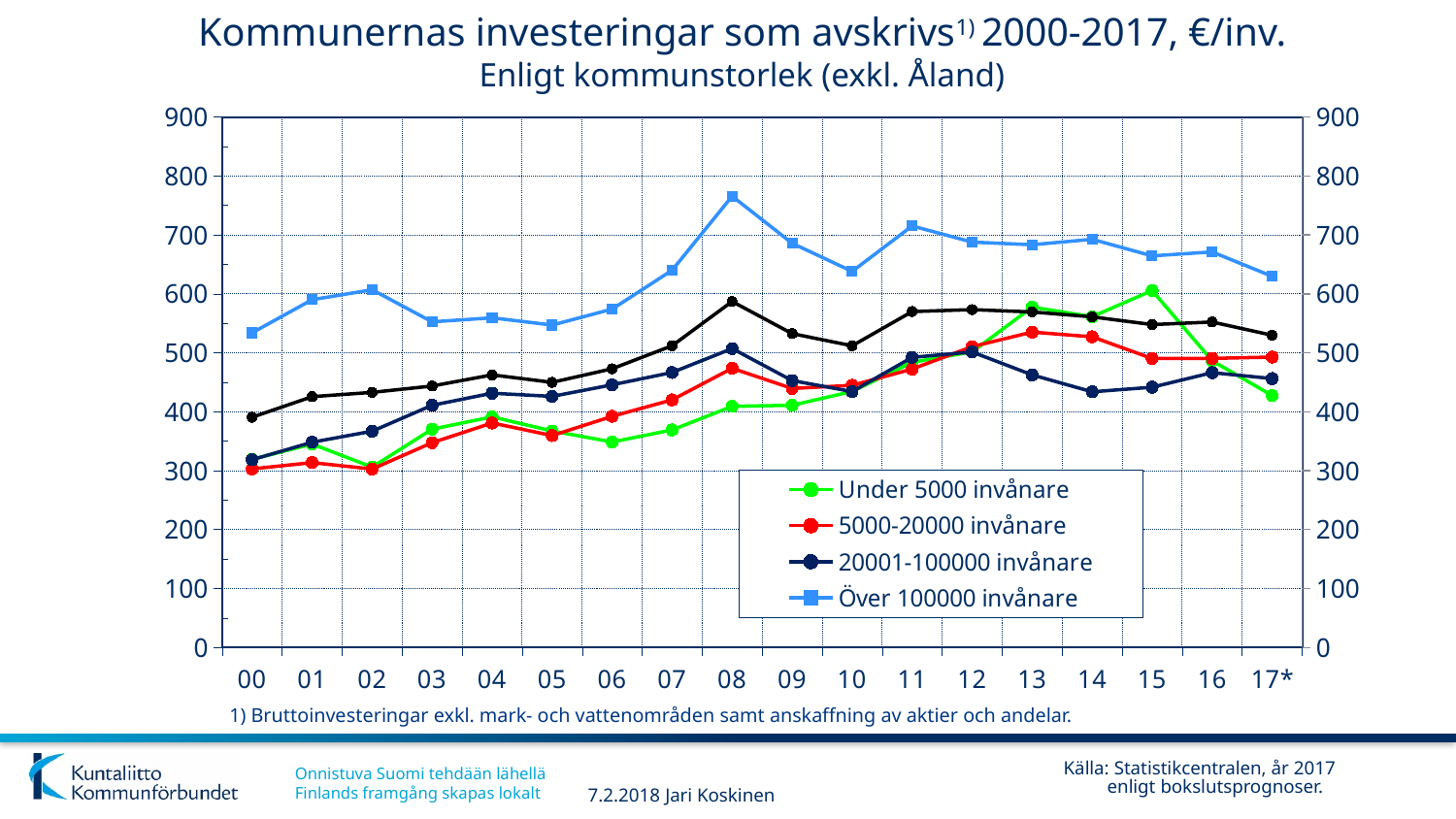
In which year does the 'Över 100000 invånare' series reach its highest value? 08 Does the 'Under 5000 invånare' series rise or fall from 15 to 17*? fall Which series has the highest value in 17*? Över 100000 invånare How many series does the legend list? 4 Which series is plotted in green? Under 5000 invånare In 15, which is larger: 'Under 5000 invånare' or '5000-20000 invånare'? Under 5000 invånare Is the value for 'Över 100000 invånare' in 08 greater or less than 700? greater In 00, which is larger: 'Över 100000 invånare' or '20001-100000 invånare'? Över 100000 invånare What kind of chart is shown on the slide? line chart How many years are shown along the x axis? 18 Is the value for 'Under 5000 invånare' in 02 greater or less than 400? less